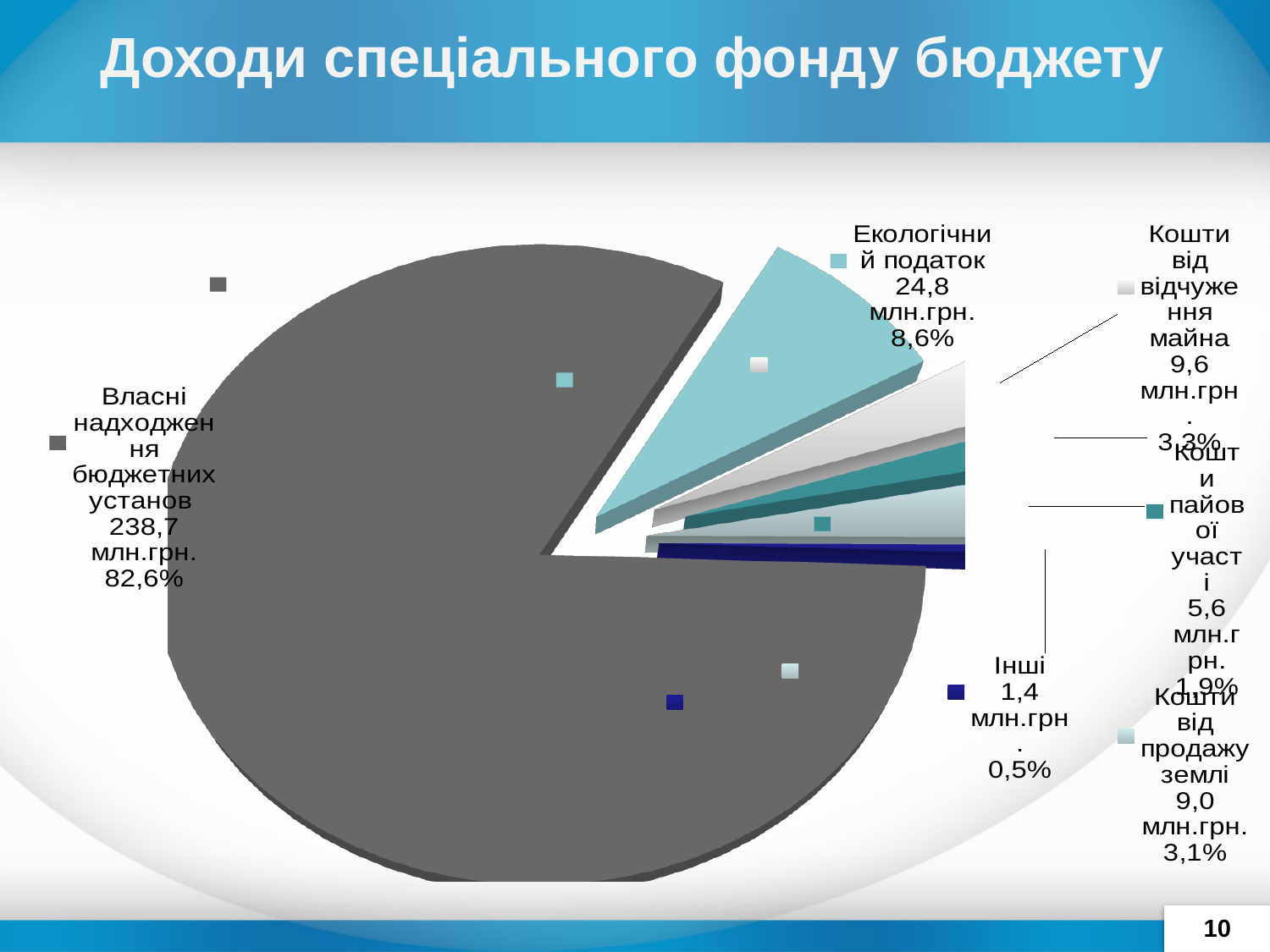
How many slices does the pie chart have? 6 What is the title of the slide's chart? Доходи спеціального фонду бюджету What kind of chart is shown on the slide? pie chart What is the value shown for "Кошти пайової участі"? 5,6 млн.грн. Which category has the smallest slice of the pie? Інші Which is larger: "Кошти від відчуження майна" or "Кошти від продажу землі"? Кошти від відчуження майна What is the value shown for "Екологічний податок"? 24,8 млн.грн. What percentage is shown for "Кошти від продажу землі"? 3,1% What is the value shown for "Власні надходження бюджетних установ"? 238,7 млн.грн. What percentage is shown for "Інші"? 0,5% What share of the pie does "Власні надходження бюджетних установ" represent? 82,6% Which category has the largest slice of the pie? Власні надходження бюджетних установ